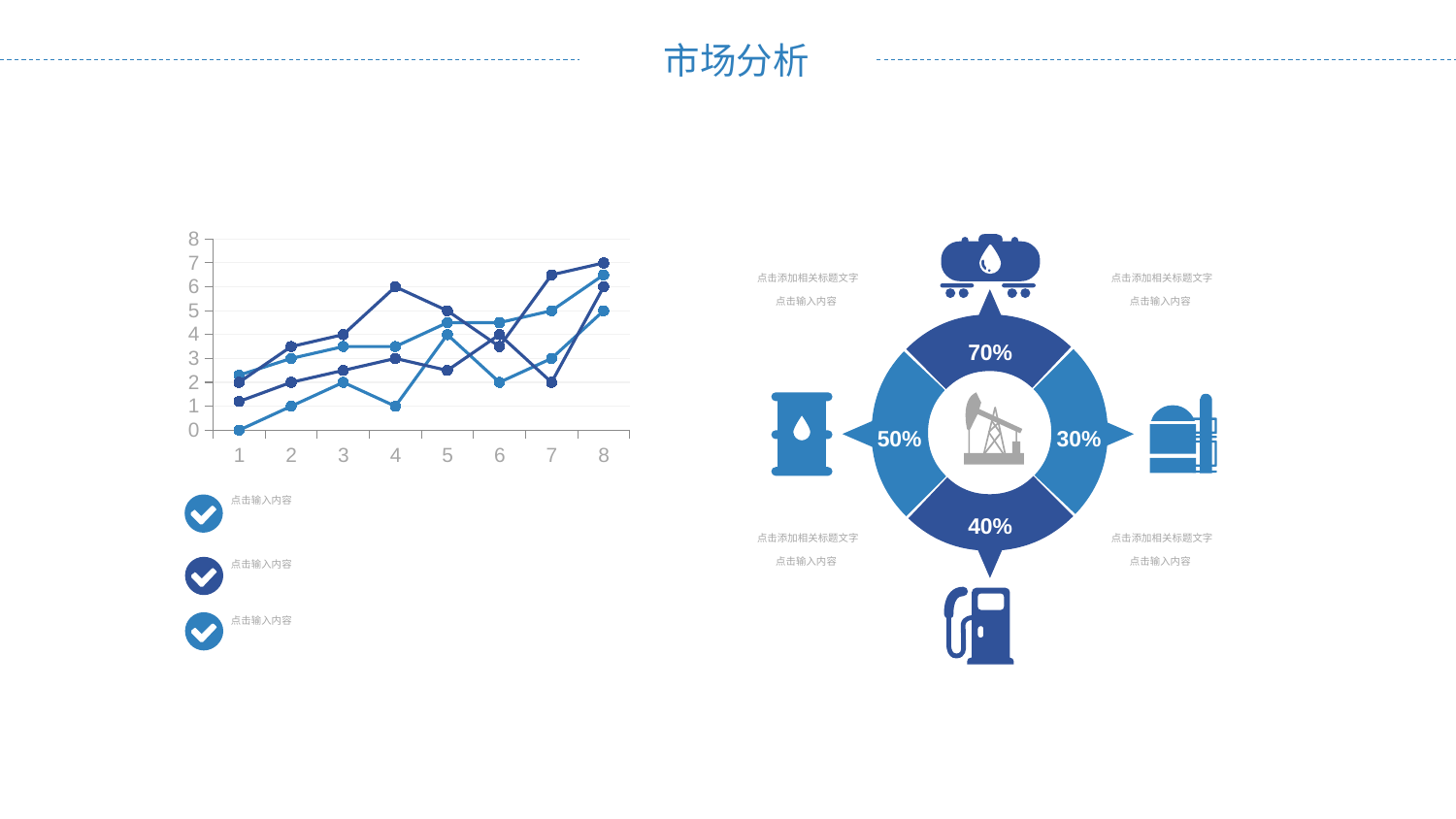
In the line chart, what is the highest value reached at x = 4? 6 What is the lowest value plotted in the line chart? 0 What kind of chart is shown on the left of the slide? line chart In the line chart, is the highest value at x = 1 greater or less than 3? less What is the highest value plotted in the line chart? 7 Do the values in the line chart generally rise or fall from x = 1 to x = 8? rise What is the title of the slide? 市场分析 How many lines are plotted in the line chart? 4 In the line chart, is the lowest value at x = 8 greater or less than 4? greater What is the highest tick shown on the y axis of the line chart? 8 How many points are labelled along the x axis of the line chart? 8